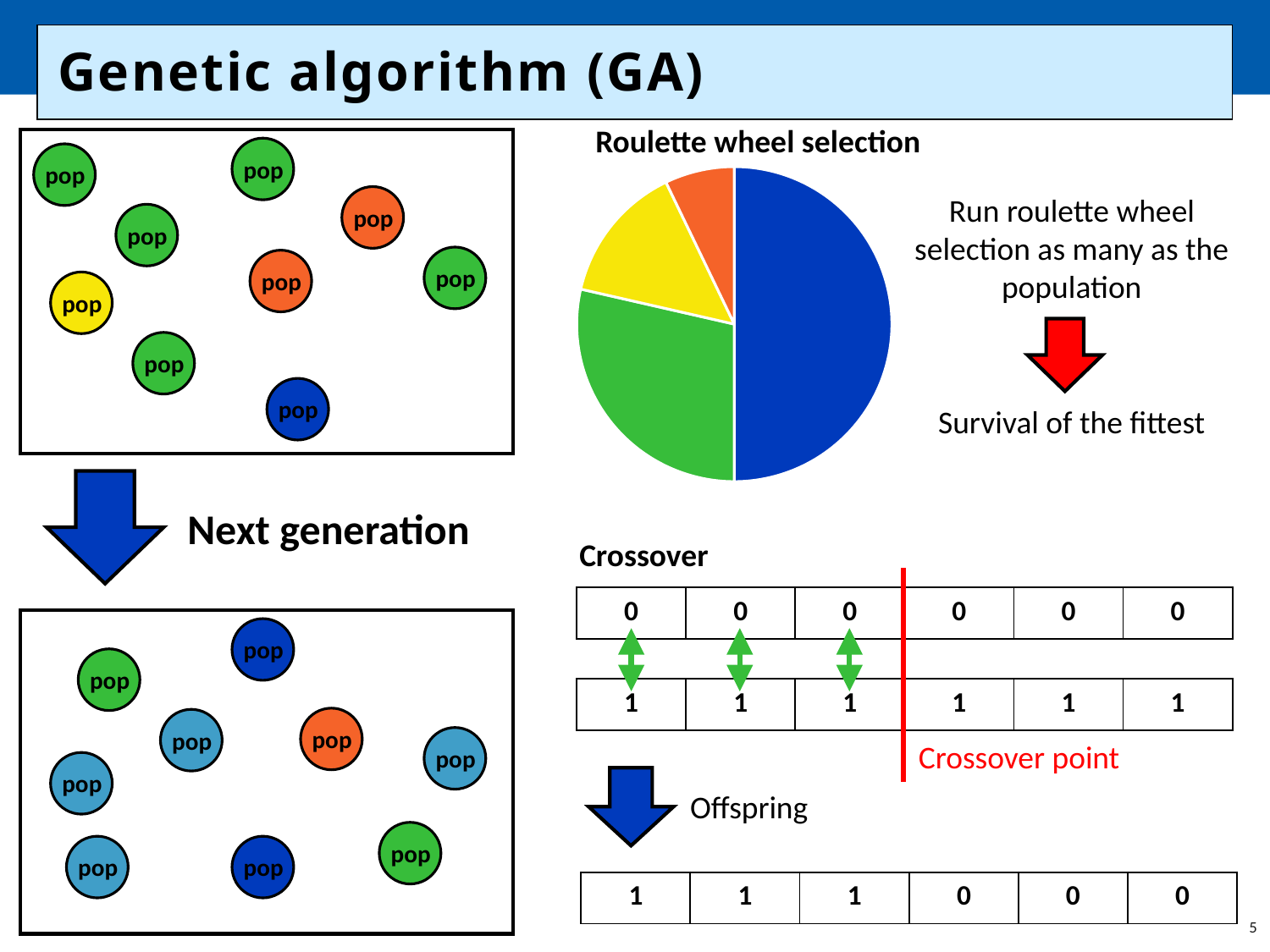
What is the heading written above the pie chart on the slide? Roulette wheel selection Which colour slice is the smallest in the "Roulette wheel selection" pie chart? orange Which colour slice is the largest in the "Roulette wheel selection" pie chart? blue What kind of chart is shown under the heading "Roulette wheel selection"? pie chart How many slices does the "Roulette wheel selection" pie chart have? 4 Does the "Roulette wheel selection" pie chart show a legend? No In the "Roulette wheel selection" pie chart, which slice is larger, the green one or the orange one? green In the "Roulette wheel selection" pie chart, which slice is larger, the blue one or the yellow one? blue In the "Roulette wheel selection" pie chart, which slice is larger, the yellow one or the orange one? yellow